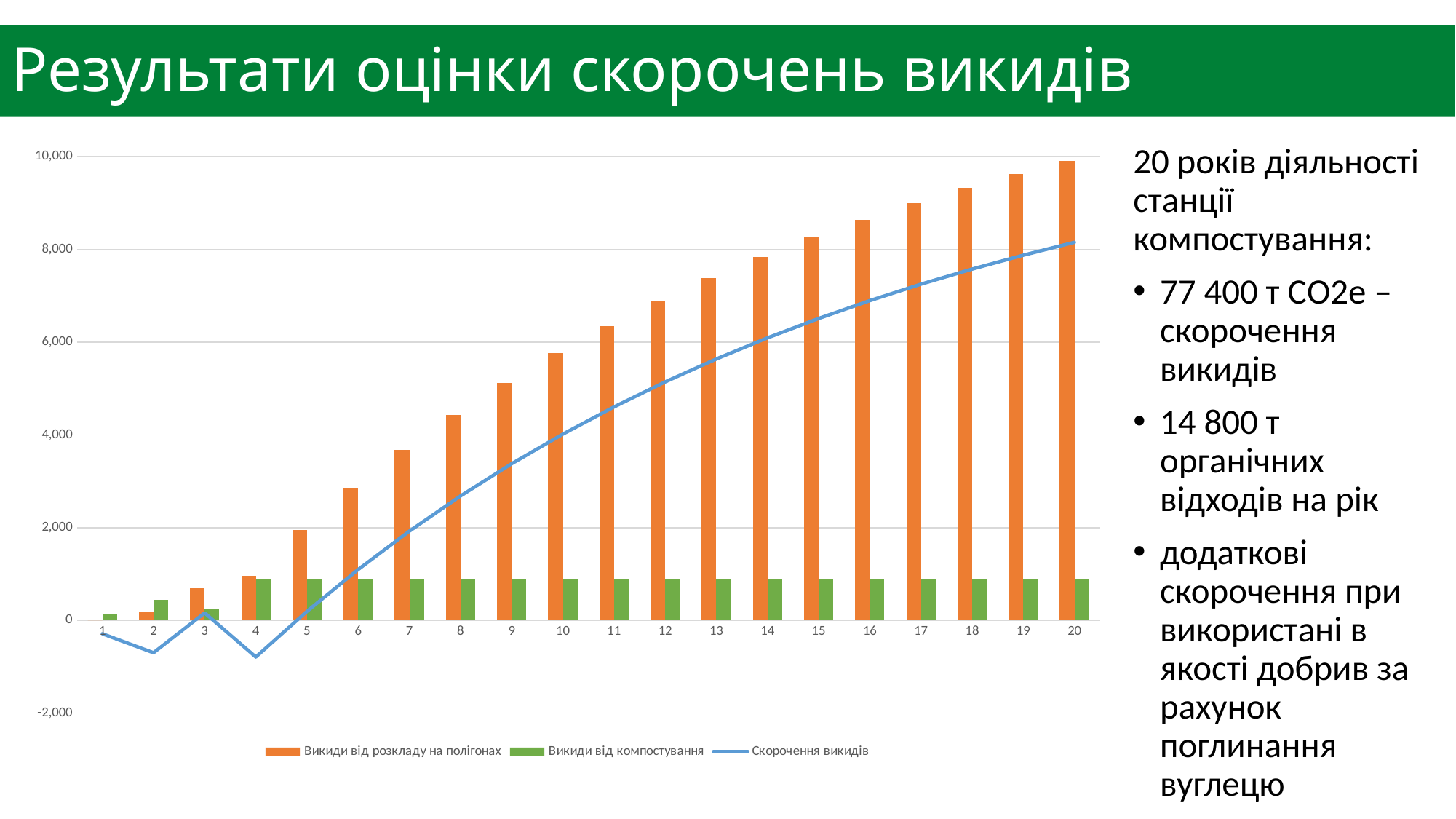
In which year is the value for 'Викиди від розкладу на полігонах' highest? 20 Is the value of the 'Скорочення викидів' line in year 2 greater or less than 0? less Which colour represents 'Скорочення викидів' in the chart? Blue Is the value for 'Викиди від компостування' in year 10 greater or less than 2,000? less What kind of chart is shown on the slide? A combined bar and line chart In year 10, which is larger: 'Викиди від розкладу на полігонах' or 'Викиди від компостування'? Викиди від розкладу на полігонах Is the value for 'Викиди від розкладу на полігонах' in year 20 greater or less than 8,000? greater How many series does the chart legend list? 3 How many categories (years) are shown on the x axis of the chart? 20 Do the values for 'Викиди від розкладу на полігонах' rise or fall from year 1 to year 20? rise In which year is the value for 'Викиди від розкладу на полігонах' lowest? 1